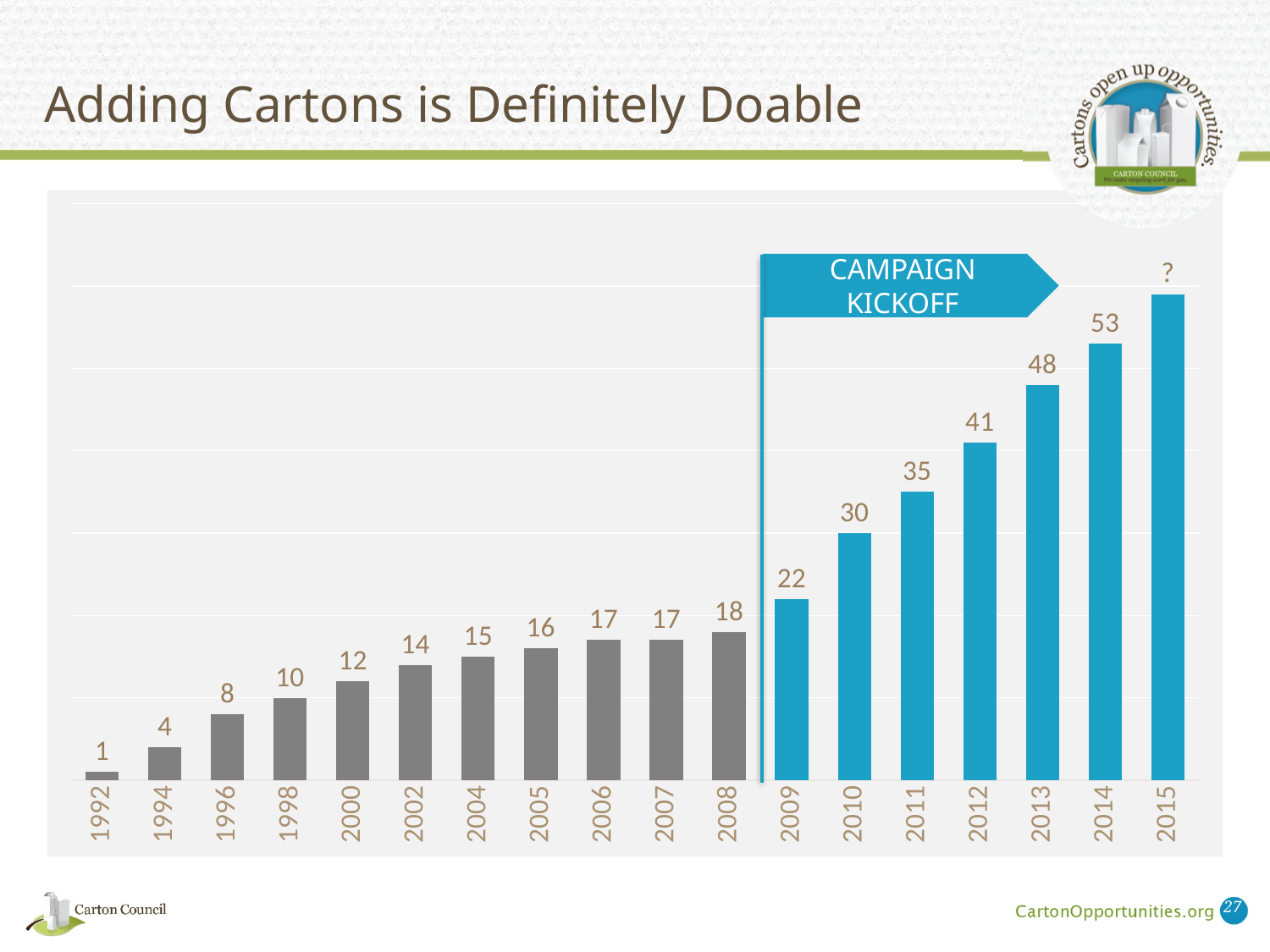
Which year has the highest labelled value? 2014 What is the value for 2011? 35 How many years are shown on the x axis? 18 What is the value for 1992? 1 What kind of chart is shown on the slide? Bar chart Which is larger, the value for 2009 or the value for 2008? 2009 What is the difference between the values for 2013 and 2012? 7 What label is shown on the arrow above the 2009 bar? CAMPAIGN KICKOFF Do the values rise or fall from 1992 to 2014? Rise Which year has the lowest labelled value? 1992 What is the value for 2008? 18 What is the value for 2014? 53